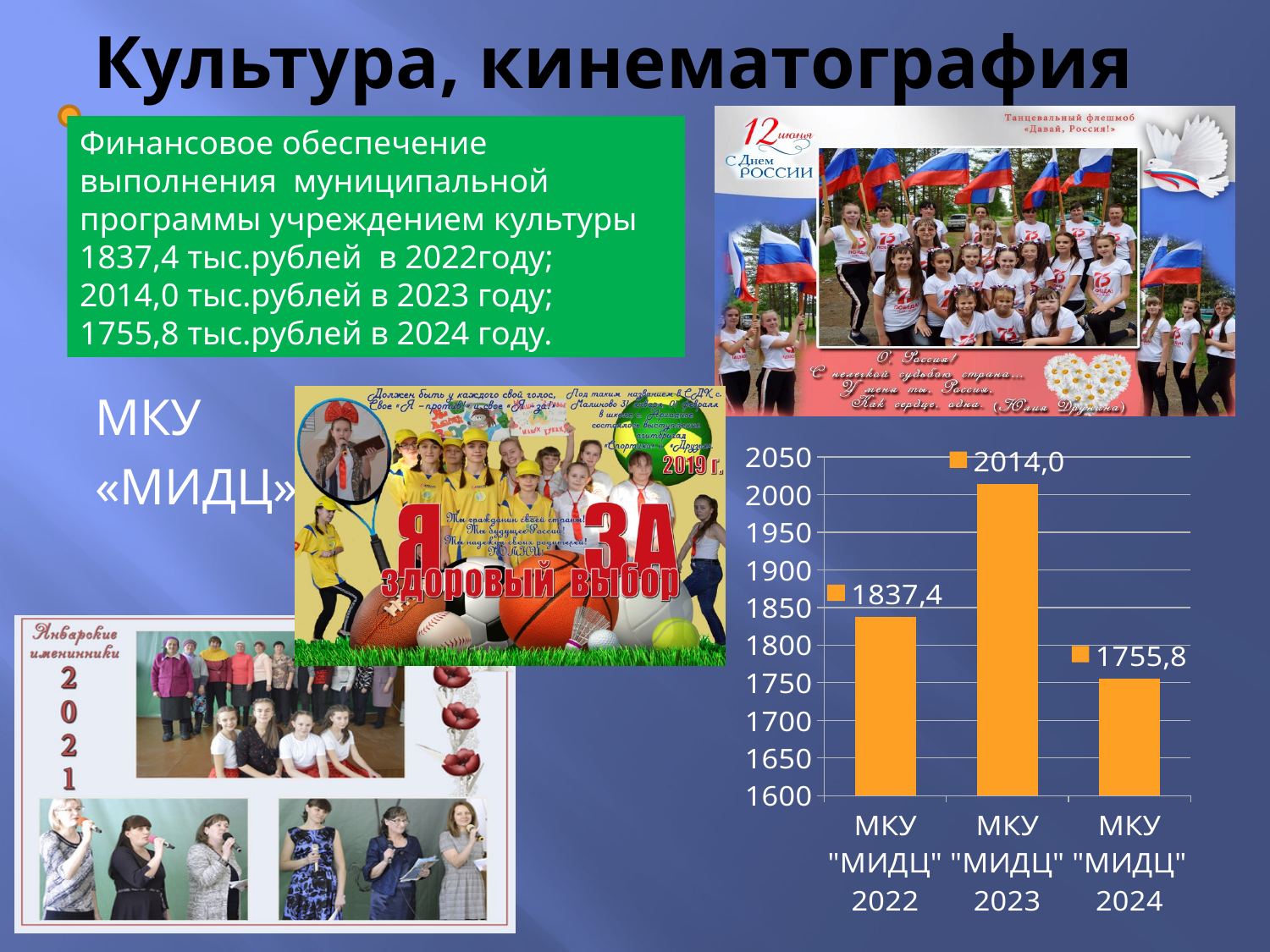
What is the value for МКУ "МИДЦ" 2024 in the bar chart? 1755,8 What is the value for МКУ "МИДЦ" 2023 in the bar chart? 2014,0 What is the difference between the 2023 and 2022 values in the bar chart? 176,6 What is the value for МКУ "МИДЦ" 2022 in the bar chart? 1837,4 Which year has the lowest value in the bar chart? МКУ "МИДЦ" 2024 Which year has the highest value in the bar chart? МКУ "МИДЦ" 2023 What kind of chart is shown on the slide? bar chart What is the difference between the 2022 and 2024 values in the bar chart? 81,6 What is the lowest value shown on the vertical axis of the chart? 1600 Is the value for МКУ "МИДЦ" 2023 greater or less than 2000? greater Which is larger in the bar chart: the value for 2022 or the value for 2024? 2022 How many bars are shown in the chart? 3